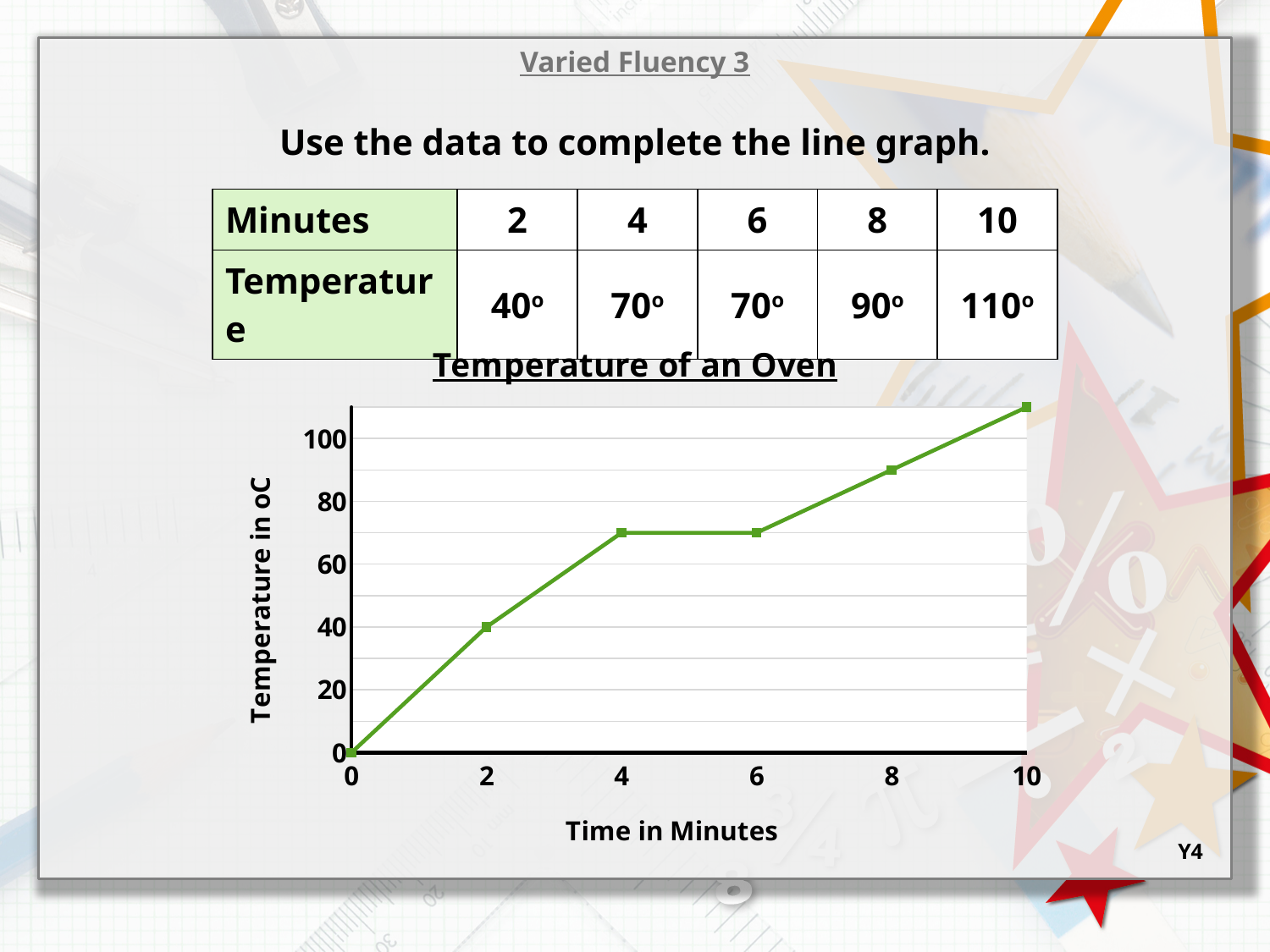
What is the temperature of the oven at 2 minutes? 40° Which is higher, the temperature at 8 minutes or the temperature at 4 minutes? 8 minutes At which time in minutes is the oven temperature highest? 10 What is the label on the vertical axis of the chart? Temperature in oC How many points are plotted on the line graph? 6 Is the temperature at 4 minutes greater or less than 60? greater What is the temperature of the oven at 10 minutes? 110° What is the temperature of the oven at 8 minutes? 90° What kind of chart is shown on the slide? line chart What is the difference between the temperature at 10 minutes and the temperature at 2 minutes? 70° At which time in minutes is the oven temperature lowest? 0 Does the temperature generally rise or fall as time in minutes increases? rise